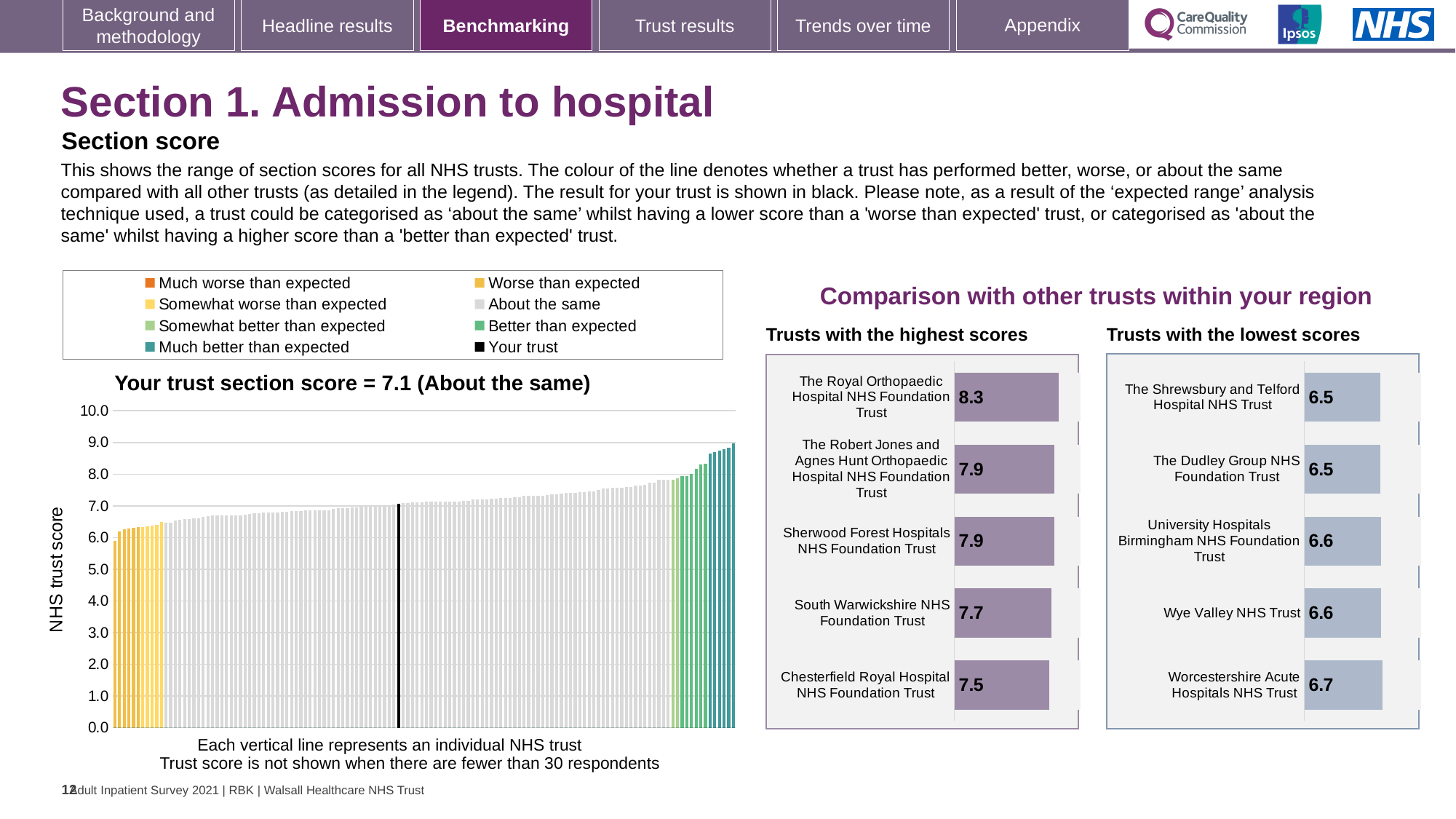
On the 'Your trust section score' chart, do the bars rise or fall from left to right along the x axis? rise On the 'Your trust section score' chart, what is the section score for your trust? 7.1 On the 'Trusts with the highest scores' chart, which trust has the lowest score? Chesterfield Royal Hospital NHS Foundation Trust On the 'Trusts with the lowest scores' chart, what is the score for Wye Valley NHS Trust? 6.6 On the 'Your trust section score' chart, is the value of the tallest bar greater or less than 8.0? greater On the 'Trusts with the highest scores' chart, which trust has the highest score? The Royal Orthopaedic Hospital NHS Foundation Trust On the 'Trusts with the highest scores' chart, what is the difference between the scores of The Royal Orthopaedic Hospital NHS Foundation Trust and Chesterfield Royal Hospital NHS Foundation Trust? 0.8 In the legend of the 'Your trust section score' chart, what colour represents 'Your trust'? black On the 'Trusts with the lowest scores' chart, which trust has the highest score? Worcestershire Acute Hospitals NHS Trust On the 'Trusts with the highest scores' chart, how many trusts are shown? 5 What kind of chart is the 'Your trust section score' chart? bar chart How many entries does the legend above the 'Your trust section score' chart list? 8